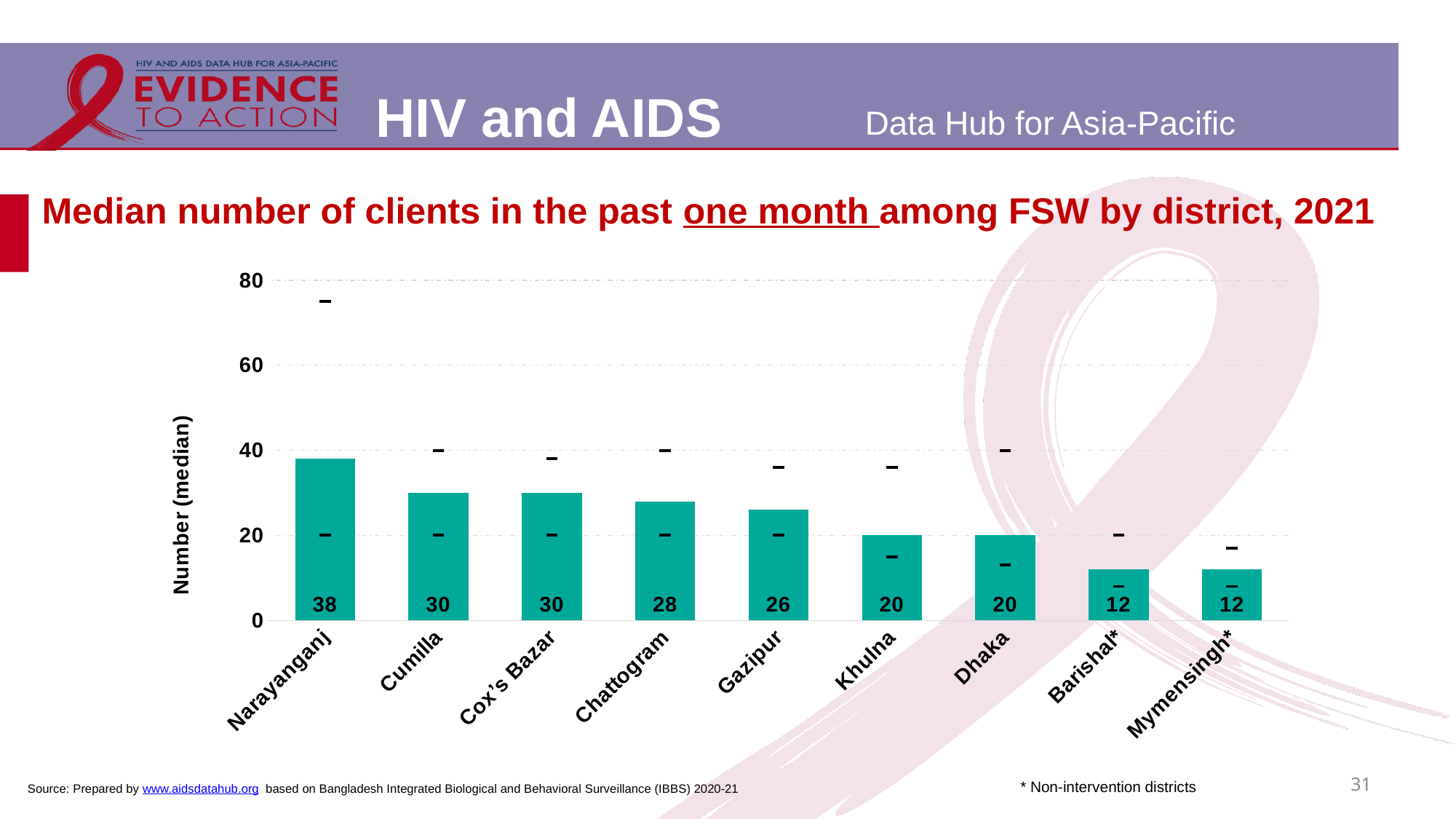
How many districts are shown on the chart? 9 What is the label of the vertical axis? Number (median) What is the difference between the median number of clients in Narayanganj and in Dhaka? 18 What is the median number of clients in the past one month among FSW in Narayanganj? 38 What kind of chart is shown on the slide? Bar chart What is the median number of clients in the past one month among FSW in Chattogram? 28 Which has a larger median number of clients, Cumilla or Khulna? Cumilla What does the asterisk next to Barishal and Mymensingh indicate? Non-intervention districts What is the median number of clients in the past one month among FSW in Gazipur? 26 Is the value for Narayanganj greater or less than 40? less Do the values rise or fall from left to right across the districts? Fall Which district has the highest median number of clients in the past one month? Narayanganj